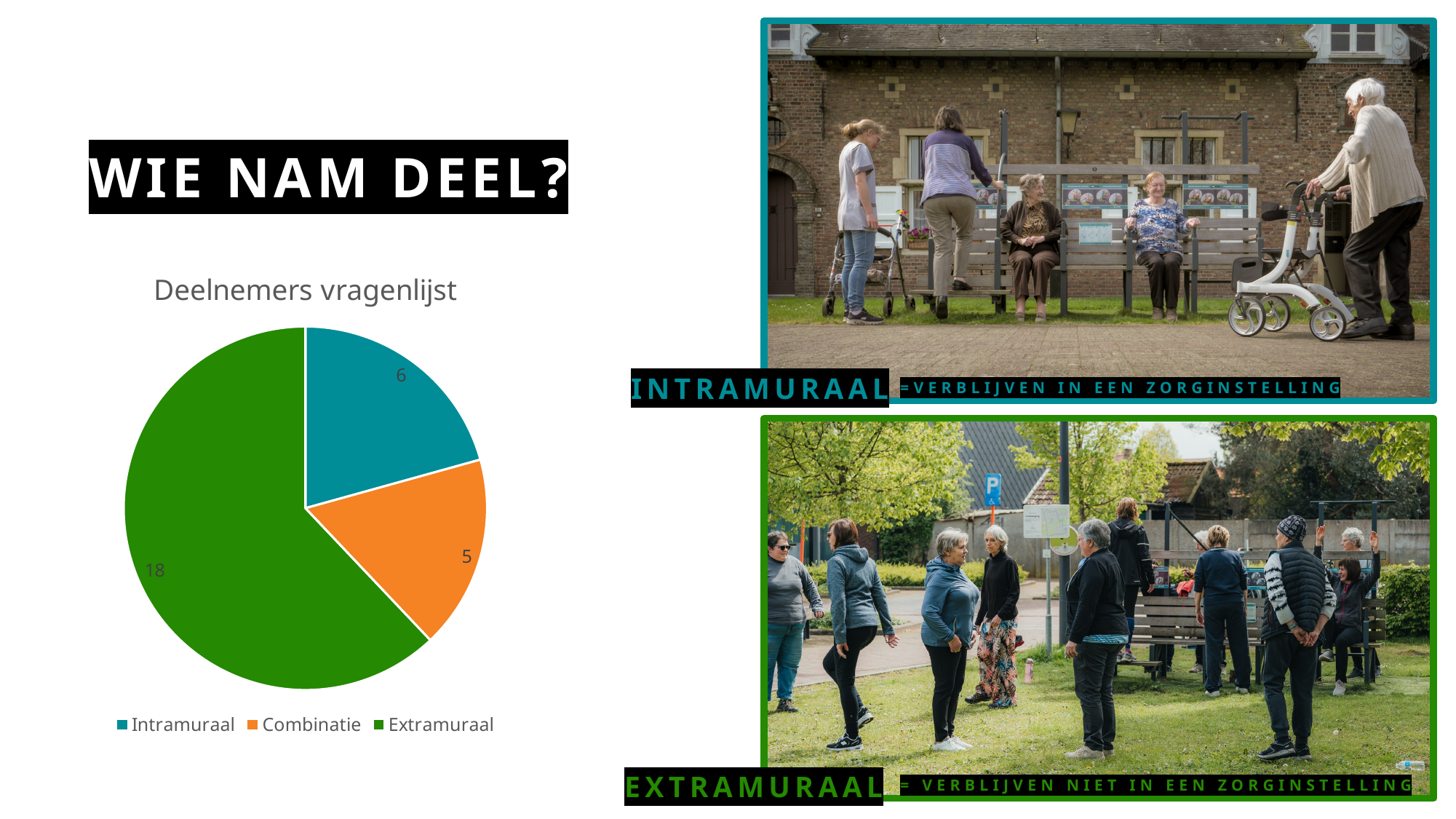
How many slices does the pie chart have? 3 What is the value for Combinatie? 5 What is the title of the chart? Deelnemers vragenlijst What is the value for Intramuraal? 6 Which category has the largest slice? Extramuraal How many entries does the legend list? 3 What is the difference between the values for Extramuraal and Intramuraal? 12 Which is larger, the value for Intramuraal or the value for Combinatie? Intramuraal What type of chart is shown on the slide? pie chart What is the value for Extramuraal? 18 What is the total of all slices in the pie chart? 29 Which category has the smallest slice? Combinatie